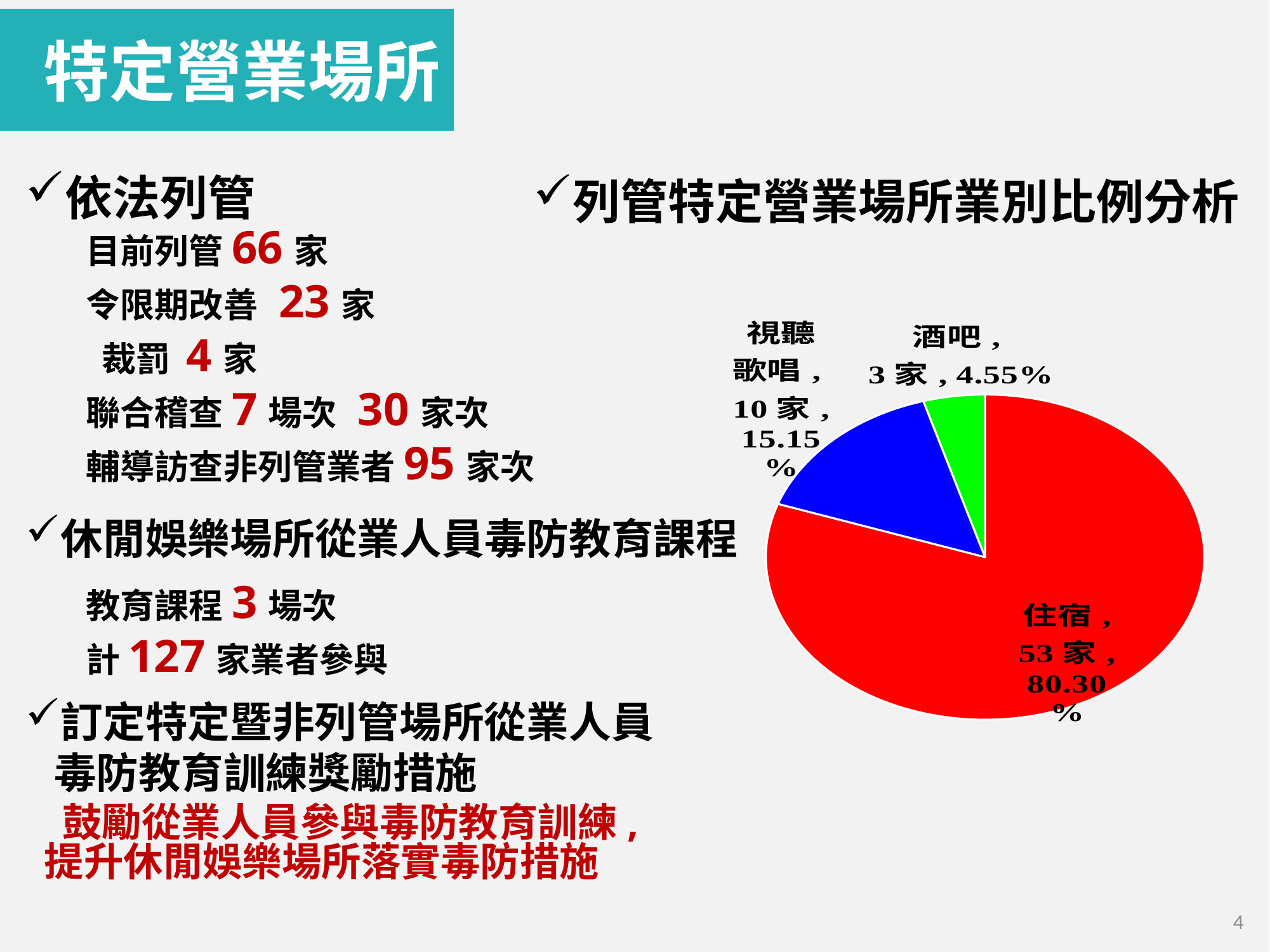
How many 家 are labelled for the 視聽歌唱 slice? 10 家 How many slices does the pie chart have? 3 Which category has the largest slice of the pie? 住宿 Which category has the smallest slice of the pie? 酒吧 What colour is the 住宿 slice? red What kind of chart is shown on the slide? pie chart What is the difference in 家 between 視聽歌唱 and 酒吧? 7 家 What share of the pie does 視聽歌唱 account for? 15.15% What share of the pie does 住宿 account for? 80.30% What share of the pie does 酒吧 account for? 4.55% How many 家 are labelled for the 住宿 slice? 53 家 How many 家 are labelled for the 酒吧 slice? 3 家